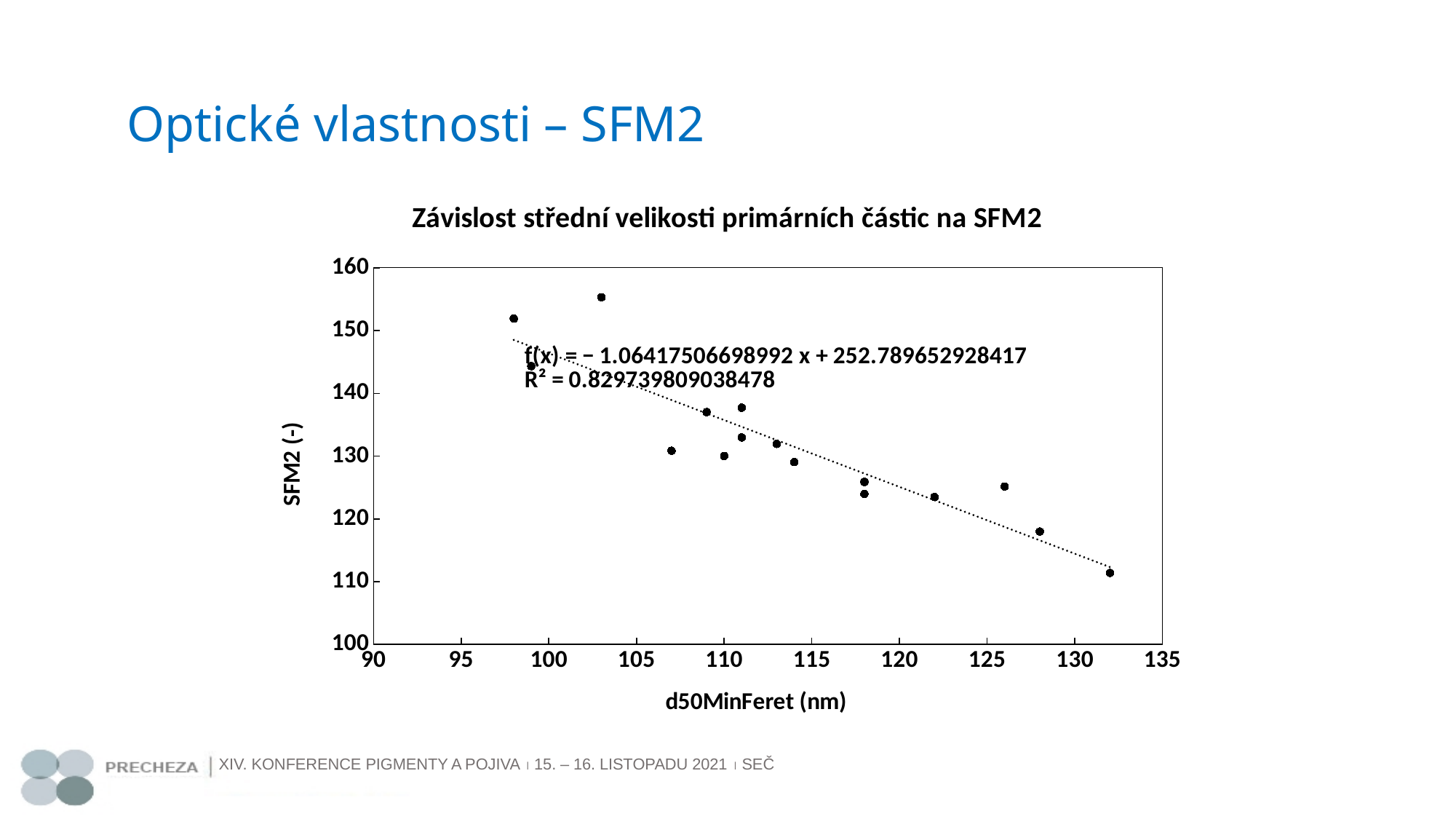
Which point has the highest SFM2 value: the one at d50MinFeret 103 nm or the one at 132 nm? 103 nm What is the title of the chart? Závislost střední velikosti primárních částic na SFM2 What kind of chart is shown on the slide? scatter chart Is the SFM2 value of the point at d50MinFeret 128 nm greater or less than 120? less Is the SFM2 value of the point at d50MinFeret 103 nm greater or less than 150? greater Is the SFM2 value of the point at d50MinFeret 132 nm greater or less than 120? less What is the label of the y axis? SFM2 (-) What is the slope of the fitted line f(x) printed on the chart? − 1.06417506698992 What R² value is printed on the chart for the trendline? 0.829739809038478 Do the SFM2 values rise or fall as d50MinFeret increases along the x axis? fall What is the intercept of the fitted line f(x) printed on the chart? 252.789652928417